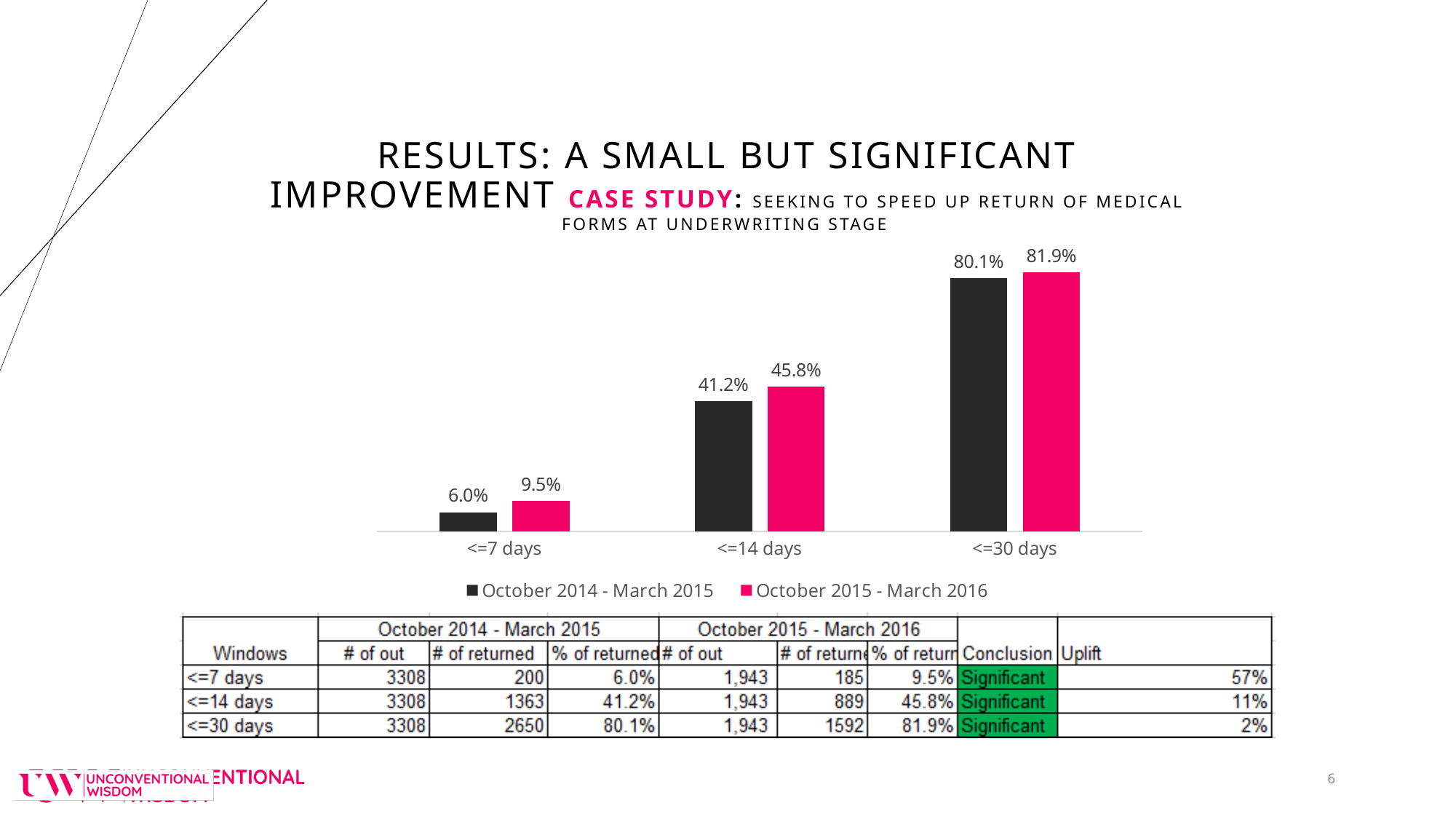
What is the value for <=7 days in the October 2015 - March 2016 series? 9.5% What is the value for <=14 days in the October 2014 - March 2015 series? 41.2% Which category has the lowest value in the October 2015 - March 2016 series? <=7 days For <=7 days, which series has the larger value: October 2014 - March 2015 or October 2015 - March 2016? October 2015 - March 2016 Do the values in the October 2014 - March 2015 series rise or fall from <=7 days to <=30 days? Rise How many series does the chart legend list? 2 Which category has the highest value in the October 2014 - March 2015 series? <=30 days How many categories are shown on the x axis of the chart? 3 What is the value for <=30 days in the October 2015 - March 2016 series? 81.9% What colour are the bars for the October 2015 - March 2016 series? Pink What kind of chart is shown on the slide? Bar chart What is the difference between the October 2015 - March 2016 and October 2014 - March 2015 values for <=14 days? 4.6%